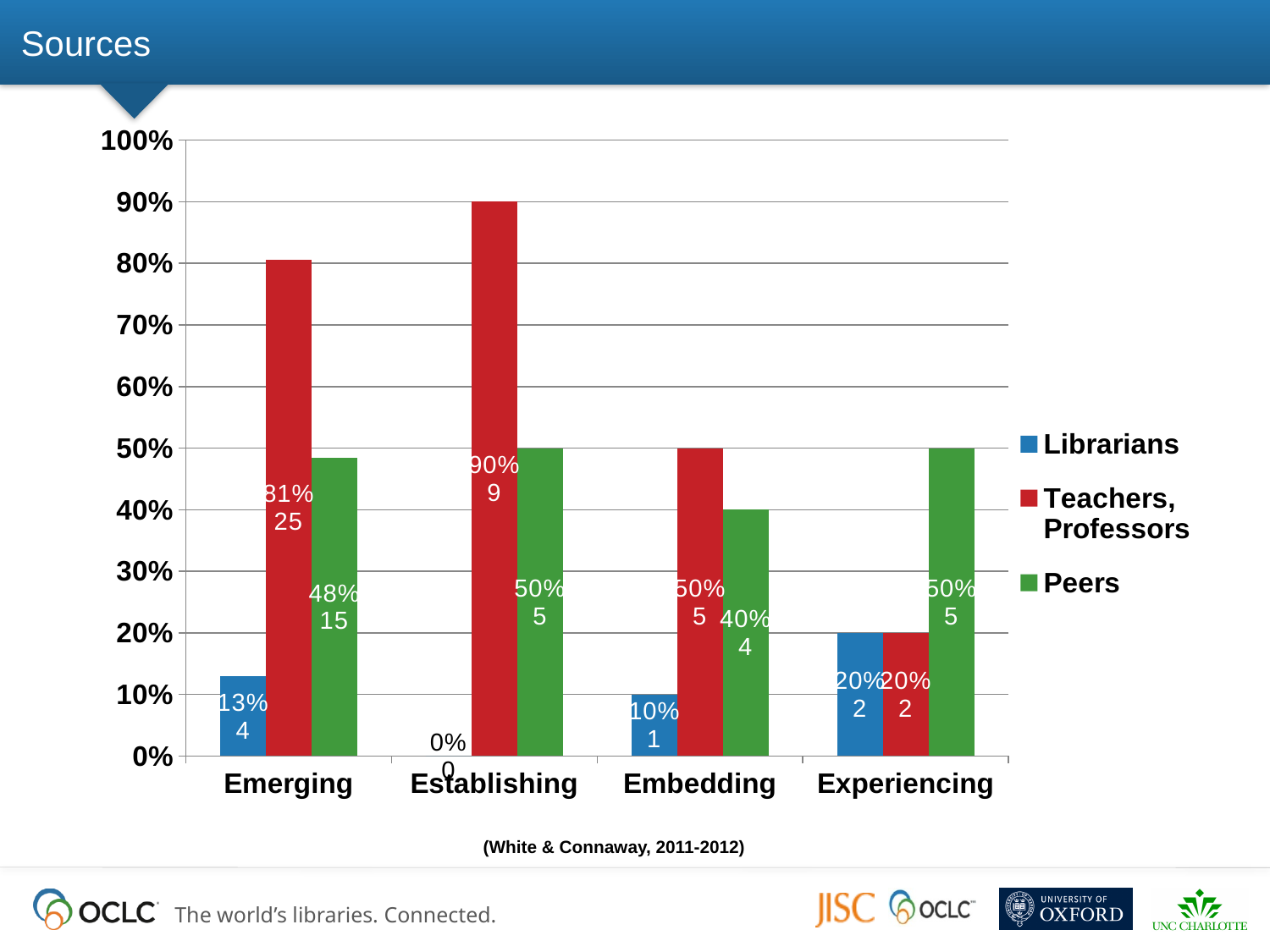
What is the percentage for Librarians in the Experiencing category? 20% Which is larger in the Embedding category, the Teachers, Professors value or the Peers value? Teachers, Professors In which category is the Librarians value lowest? Establishing In which category is the Teachers, Professors value highest? Establishing What kind of chart is shown on the slide? Bar chart What is the percentage for Librarians in the Establishing category? 0% How many categories are shown on the x axis? 4 What is the percentage for Teachers, Professors in the Emerging category? 81% What is the percentage for Peers in the Embedding category? 40% Is the value for Teachers, Professors in the Establishing category greater or less than 80%? greater What is the difference in percentage points between Teachers, Professors and Librarians in the Emerging category? 68 How many series does the legend list? 3